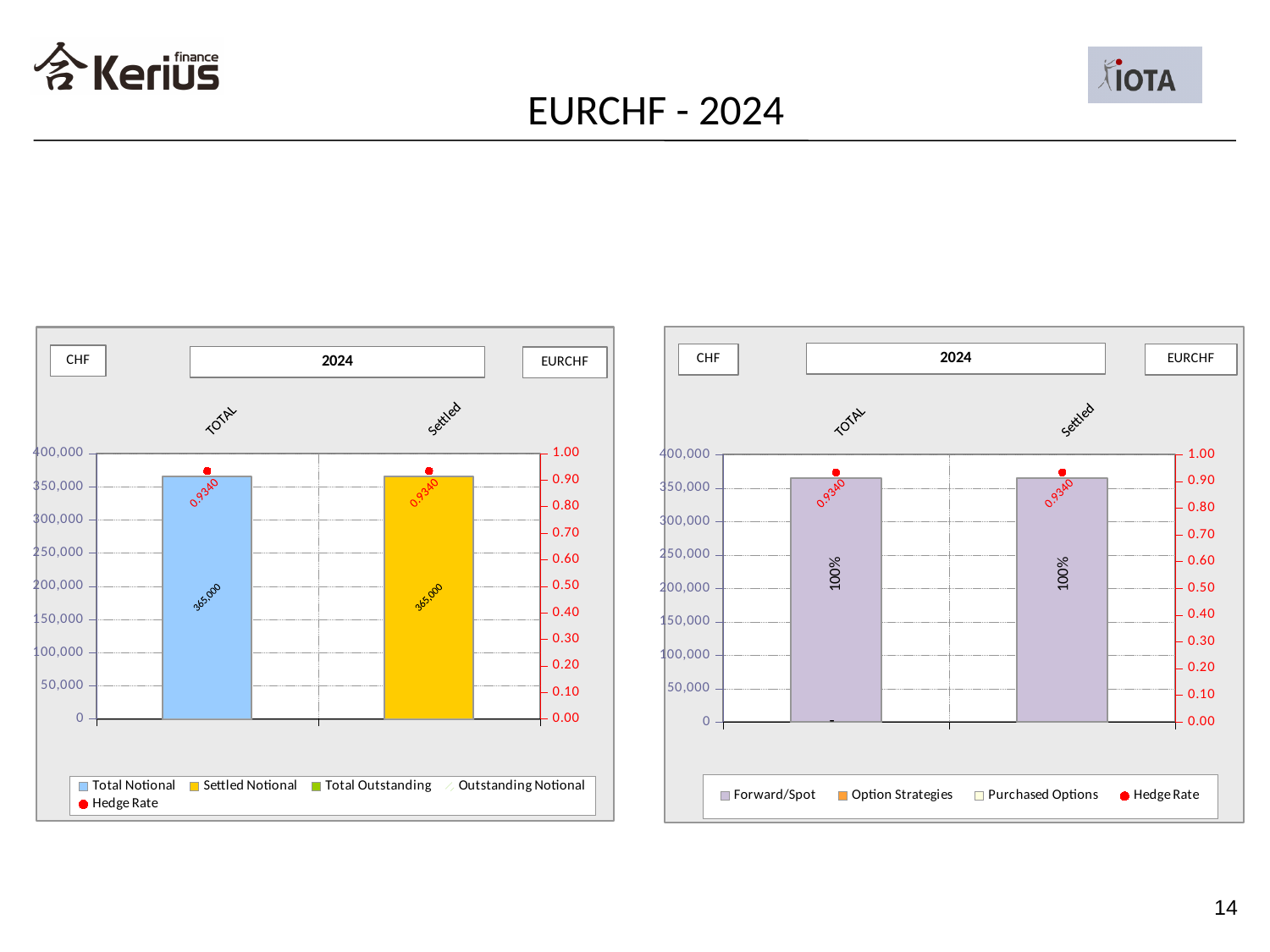
In the left chart, how many entries does the legend list? 5 In the left chart, what is the Total Notional value for the TOTAL category? 365,000 In the right chart, what is the Hedge Rate shown for the Settled category? 0.9340 In the right chart, what colour are the Forward/Spot bars? light purple In the left chart, how many categories are shown on the x axis? 2 What kind of chart is the right chart? bar chart In the left chart, what is the Settled Notional value for the Settled category? 365,000 In the left chart, what is the difference between the Total Notional for TOTAL and the Settled Notional for Settled? 0 In the right chart, how many entries does the legend list? 4 In the right chart, what percentage label is shown on the Forward/Spot bar for the Settled category? 100% In the left chart, what is the Hedge Rate shown for the TOTAL category? 0.9340 In the left chart, is the Total Notional value for TOTAL greater or less than 350,000? greater